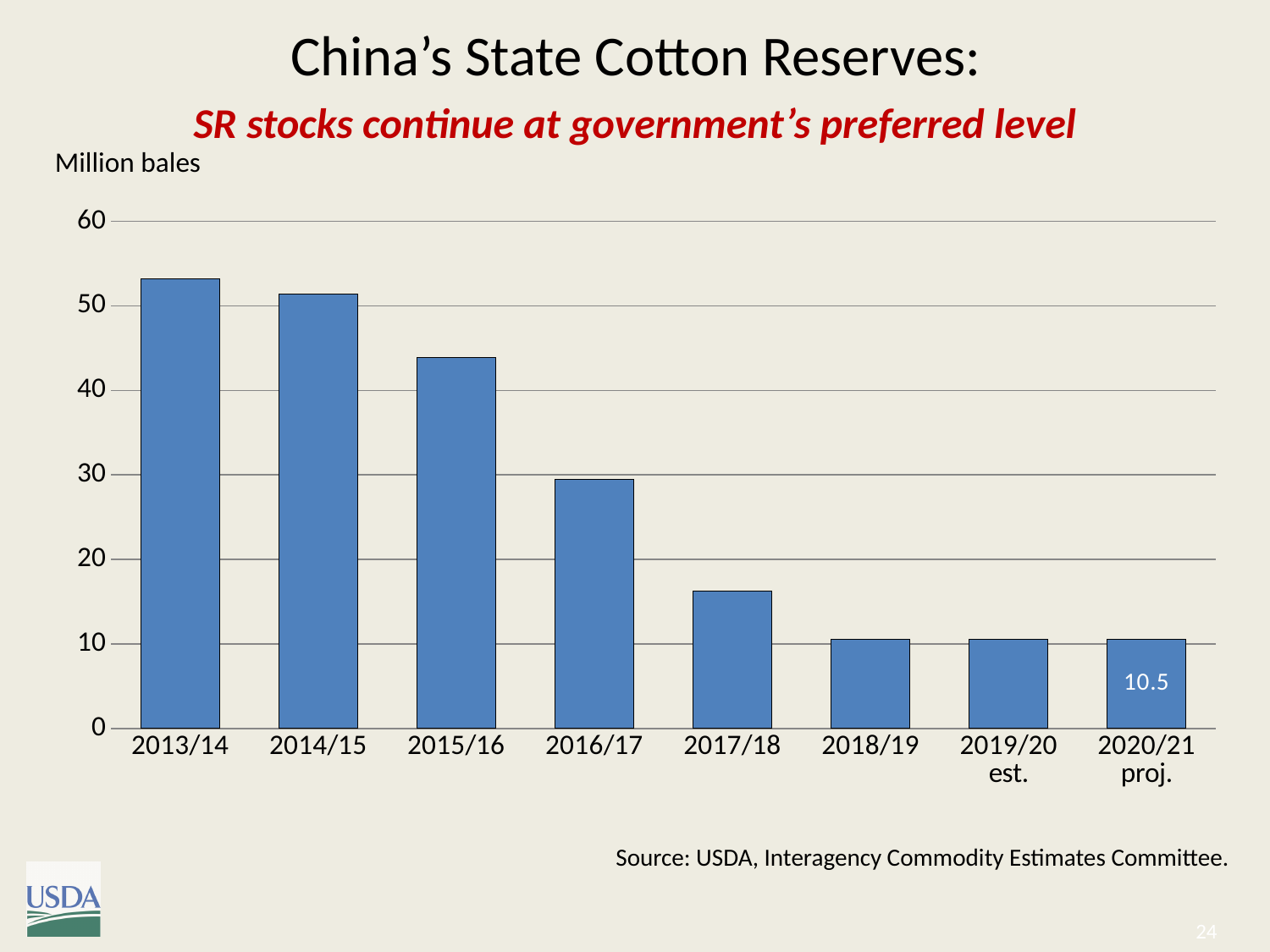
Do the values rise or fall from 2013/14 to 2017/18? fall What is the source cited on the slide? USDA, Interagency Commodity Estimates Committee What unit is shown above the y axis? Million bales What kind of chart is this? bar chart What is the value for 2020/21 proj.? 10.5 How many years are shown on the x axis? 8 Which is larger, the value for 2014/15 or the value for 2016/17? 2014/15 Is the value for 2013/14 greater or less than 50? greater Is the value for 2015/16 greater or less than 40? greater Which year has the highest value? 2013/14 Is the value for 2017/18 greater or less than 20? less